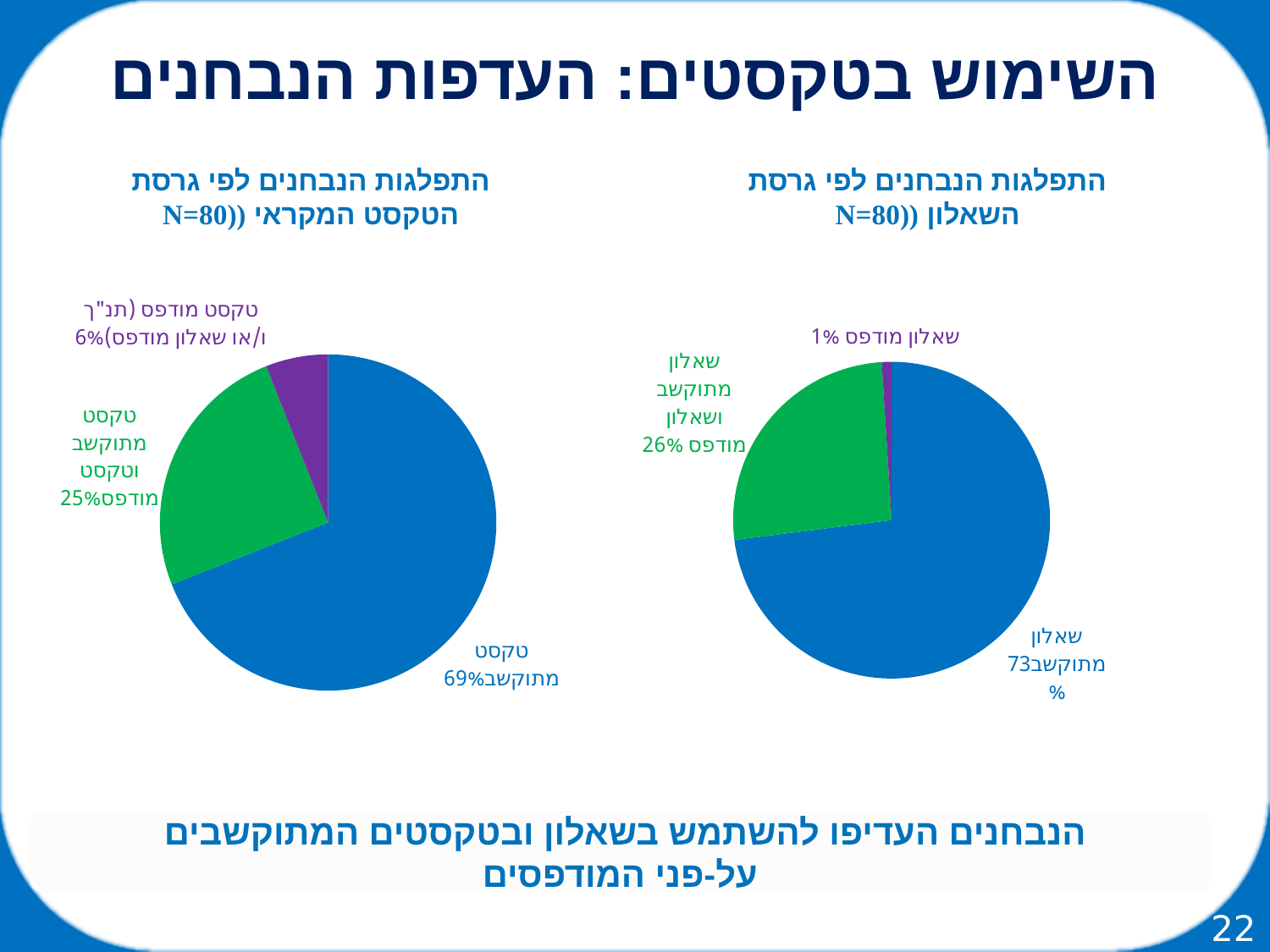
In the left-hand chart (התפלגות הנבחנים לפי גרסת הטקסט המקראי), what share is labelled 'טקסט מתוקשב וטקסט מודפס'? 25% In the right-hand chart (התפלגות הנבחנים לפי גרסת השאלון), what is the difference in percentage points between 'שאלון מתוקשב' and 'שאלון מתוקשב ושאלון מודפס'? 47 What kind of chart is the right-hand chart titled 'התפלגות הנבחנים לפי גרסת השאלון'? pie chart In the right-hand chart (התפלגות הנבחנים לפי גרסת השאלון), what share is labelled 'שאלון מודפס'? 1% In the right-hand chart (התפלגות הנבחנים לפי גרסת השאלון), which category has the largest slice? שאלון מתוקשב In the left-hand chart (התפלגות הנבחנים לפי גרסת הטקסט המקראי), which is larger: 'טקסט מתוקשב וטקסט מודפס' or 'טקסט מודפס (תנ"ך ו/או שאלון מודפס)'? טקסט מתוקשב וטקסט מודפס What sample size (N) is stated in the title of the left-hand chart (התפלגות הנבחנים לפי גרסת הטקסט המקראי)? N=80 In the right-hand chart (התפלגות הנבחנים לפי גרסת השאלון), which category has the smallest slice? שאלון מודפס In the right-hand chart (התפלגות הנבחנים לפי גרסת השאלון), what share of examinees used 'שאלון מתוקשב'? 73% In the left-hand chart (התפלגות הנבחנים לפי גרסת הטקסט המקראי), what share of examinees used 'טקסט מתוקשב'? 69% In the left-hand chart (התפלגות הנבחנים לפי גרסת הטקסט המקראי), what share is labelled 'טקסט מודפס (תנ"ך ו/או שאלון מודפס)'? 6% In the right-hand chart (התפלגות הנבחנים לפי גרסת השאלון), how many slices does the pie have? 3